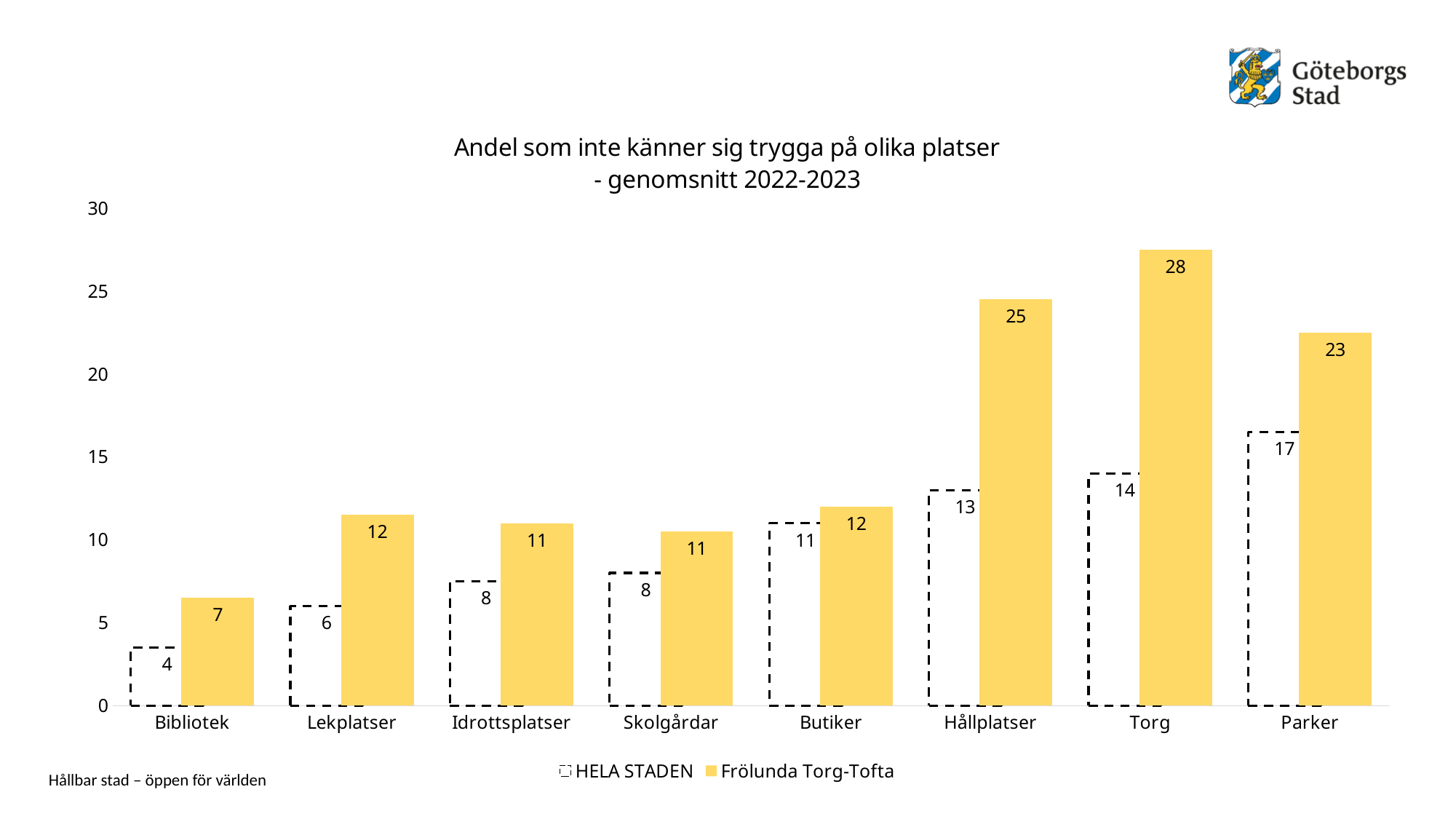
What is the title of the chart? Andel som inte känner sig trygga på olika platser - genomsnitt 2022-2023 Which category has the lowest value for HELA STADEN? Bibliotek What is the value for HELA STADEN at Parker? 17 Which category has the highest value for Frölunda Torg-Tofta? Torg What is the value for Frölunda Torg-Tofta at Hållplatser? 25 What is the value for HELA STADEN at Bibliotek? 4 What is the value for Frölunda Torg-Tofta at Torg? 28 How many series does the legend list? 2 Which is larger at Lekplatser: HELA STADEN or Frölunda Torg-Tofta? Frölunda Torg-Tofta How many categories are shown on the x axis? 8 What kind of chart is shown on the slide? Bar chart What is the difference between Frölunda Torg-Tofta and HELA STADEN at Hållplatser? 12